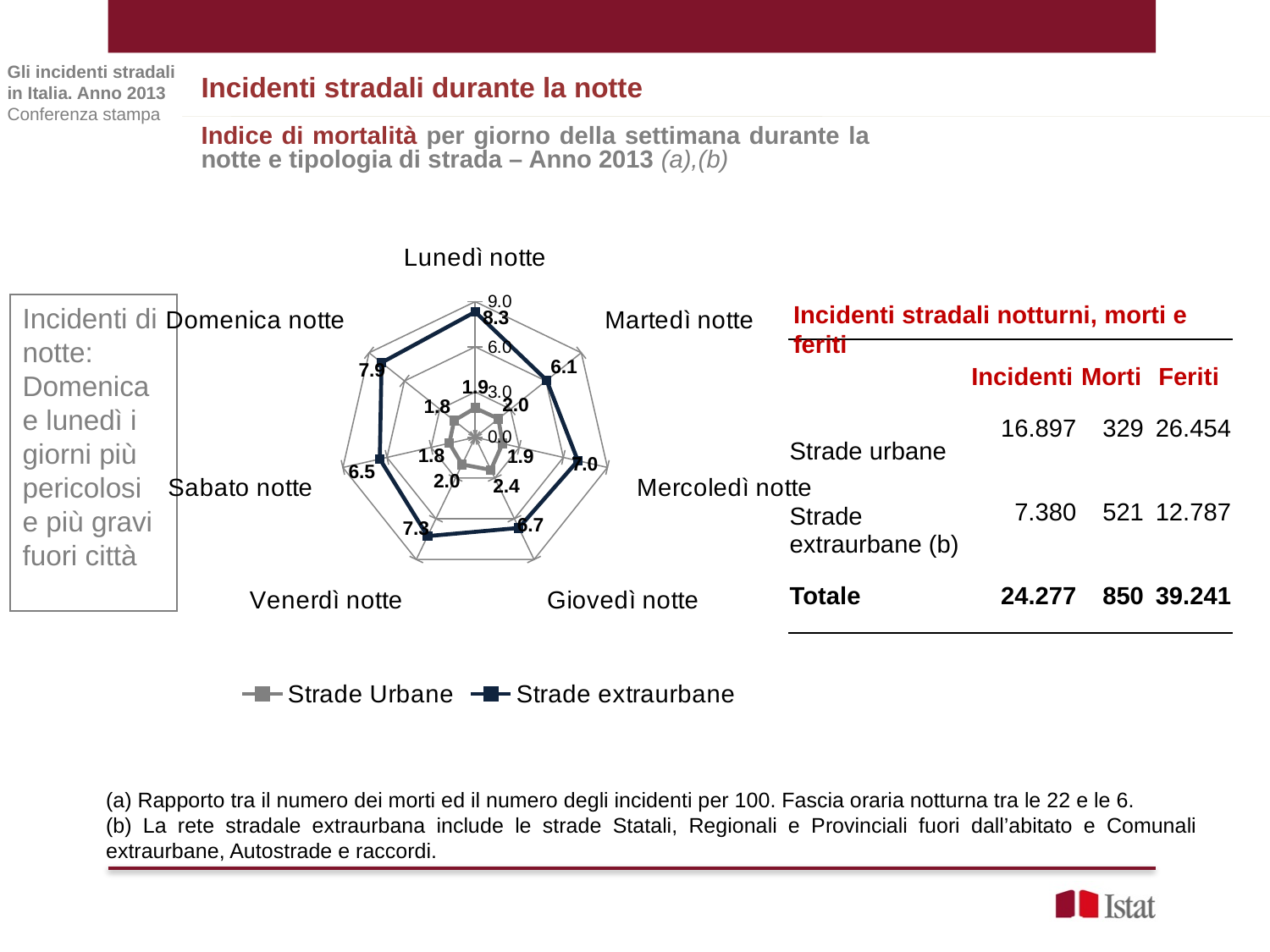
Is the value for Strade extraurbane on Mercoledì notte greater or less than 6.0? greater On Sabato notte, which series has the larger value, Strade Urbane or Strade extraurbane? Strade extraurbane How many night-of-the-week categories are plotted on the radar chart? 7 How many series does the chart legend list? 2 Which night has the highest value for Strade Urbane? Giovedì notte What is the value for Strade extraurbane on Domenica notte? 7.9 What is the value for Strade extraurbane on Lunedì notte? 8.3 Which night has the lowest value for Strade extraurbane? Martedì notte What kind of chart is shown on the slide? Radar chart Which night has the highest value for Strade extraurbane? Lunedì notte What is the difference between the Strade extraurbane and Strade Urbane values on Domenica notte? 6.1 What is the value for Strade Urbane on Giovedì notte? 2.4